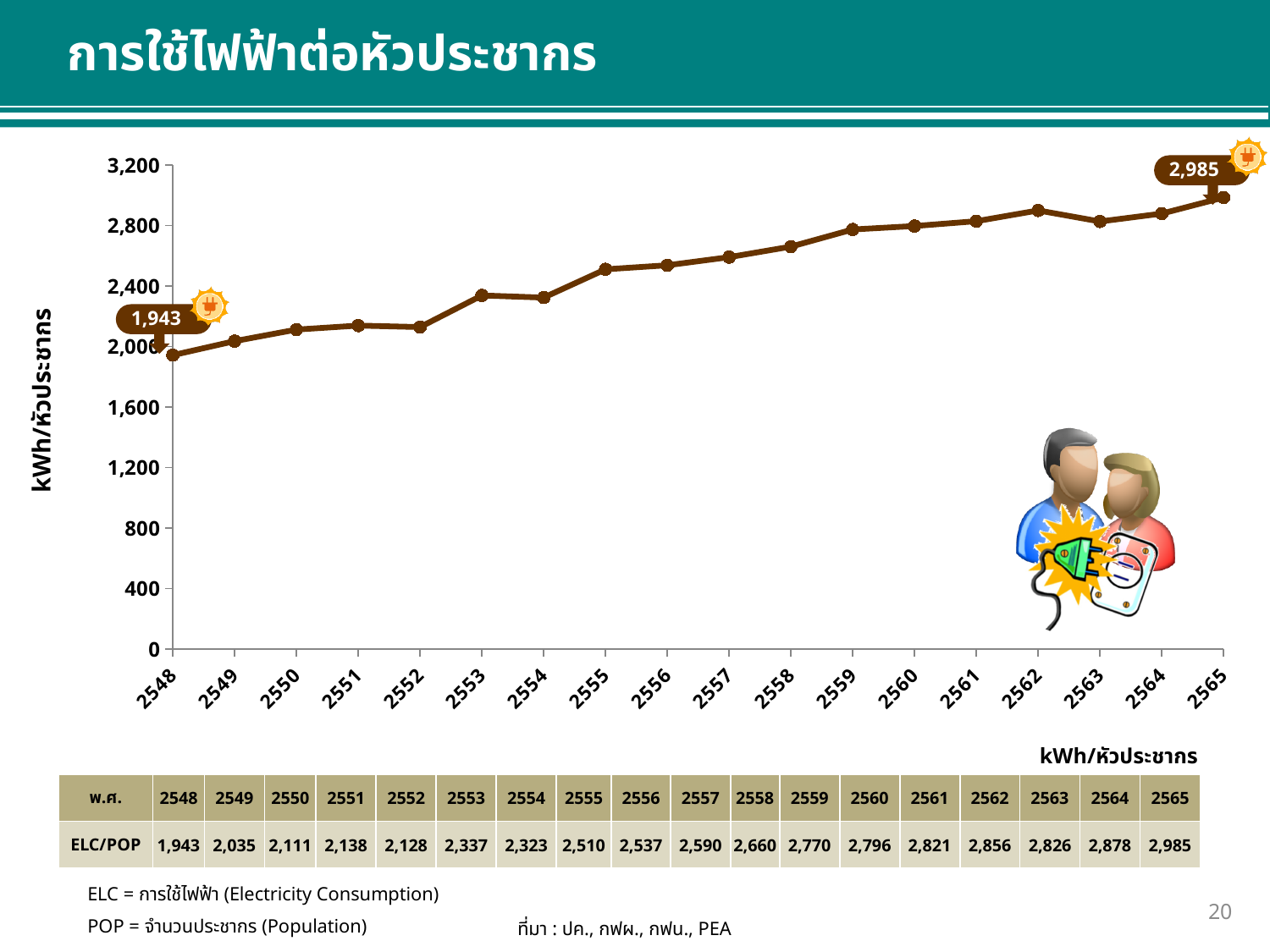
What is the difference between the values for 2565 and 2548? 1,042 Is the value for 2555 greater or less than 2,400? greater What kind of chart is shown on the slide? line chart What is the value for 2548 in the chart? 1,943 How many years are plotted in the chart? 18 What is the value for 2559 in the chart? 2,770 Which year has the lowest value in the chart? 2548 Do the values generally rise or fall from 2548 to 2565? rise What is the label on the vertical axis of the chart? kWh/หัวประชากร Which year has the larger value, 2562 or 2563? 2562 Which year has the highest value in the chart? 2565 What is the value for 2565 in the chart? 2,985